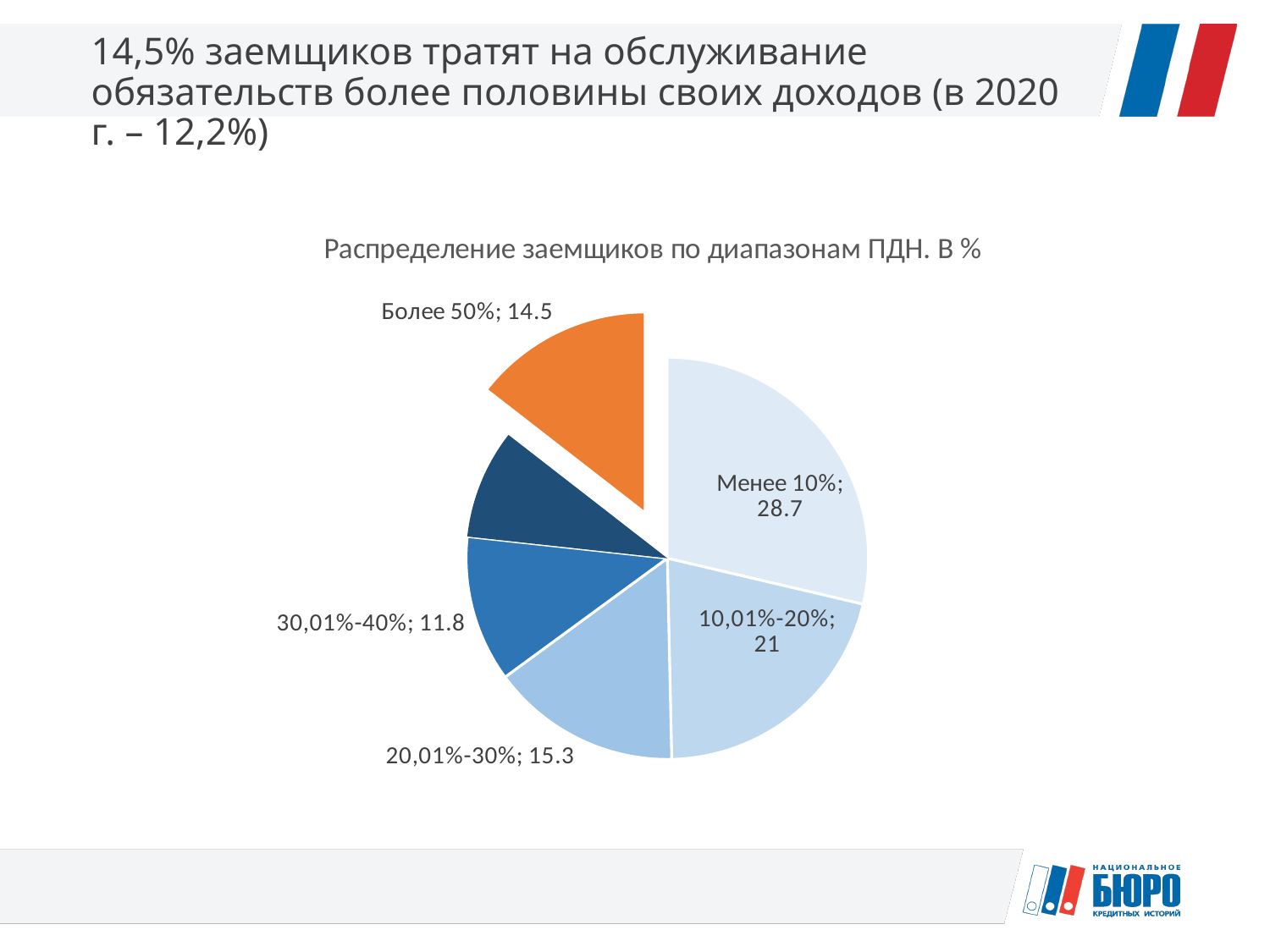
What is the difference between the values for "Менее 10%" and "10,01%-20%"? 7.7 What is the value for the "Более 50%" slice? 14.5 What is the value for the "20,01%-30%" slice? 15.3 What is the title of the chart? Распределение заемщиков по диапазонам ПДН. В % Which category has the largest share of the pie? Менее 10% What kind of chart is shown on the slide? pie chart What is the difference between the values for "20,01%-30%" and "30,01%-40%"? 3.5 How many slices does the pie chart have? 6 What is the value for the "10,01%-20%" slice? 21 Which is larger, the value for "10,01%-20%" or for "20,01%-30%"? 10,01%-20% What is the value for the "Менее 10%" slice? 28.7 What is the value for the "30,01%-40%" slice? 11.8